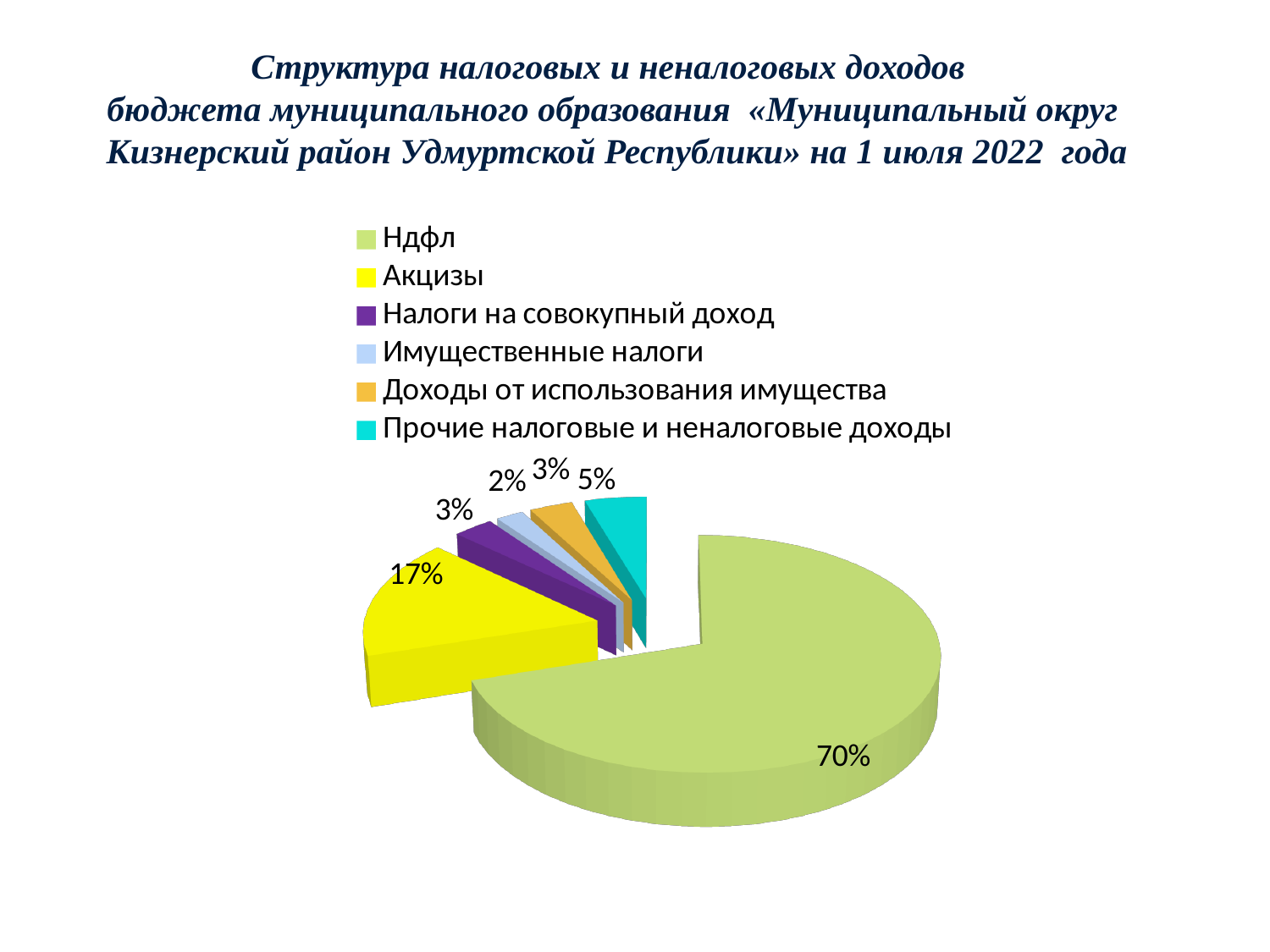
What share of the pie does Налоги на совокупный доход account for? 3% Which has a larger share, Акцизы or Прочие налоговые и неналоговые доходы? Акцизы What is the difference in percentage points between the shares of Ндфл and Акцизы? 53 Which category has the smallest share of the pie? Имущественные налоги What share of the pie does Прочие налоговые и неналоговые доходы account for? 5% What share of the pie does Ндфл account for? 70% How many categories does the pie chart show? 6 Which category has the largest share of the pie? Ндфл What type of chart is shown on the slide? Pie chart What colour is the slice for Акцизы? Yellow